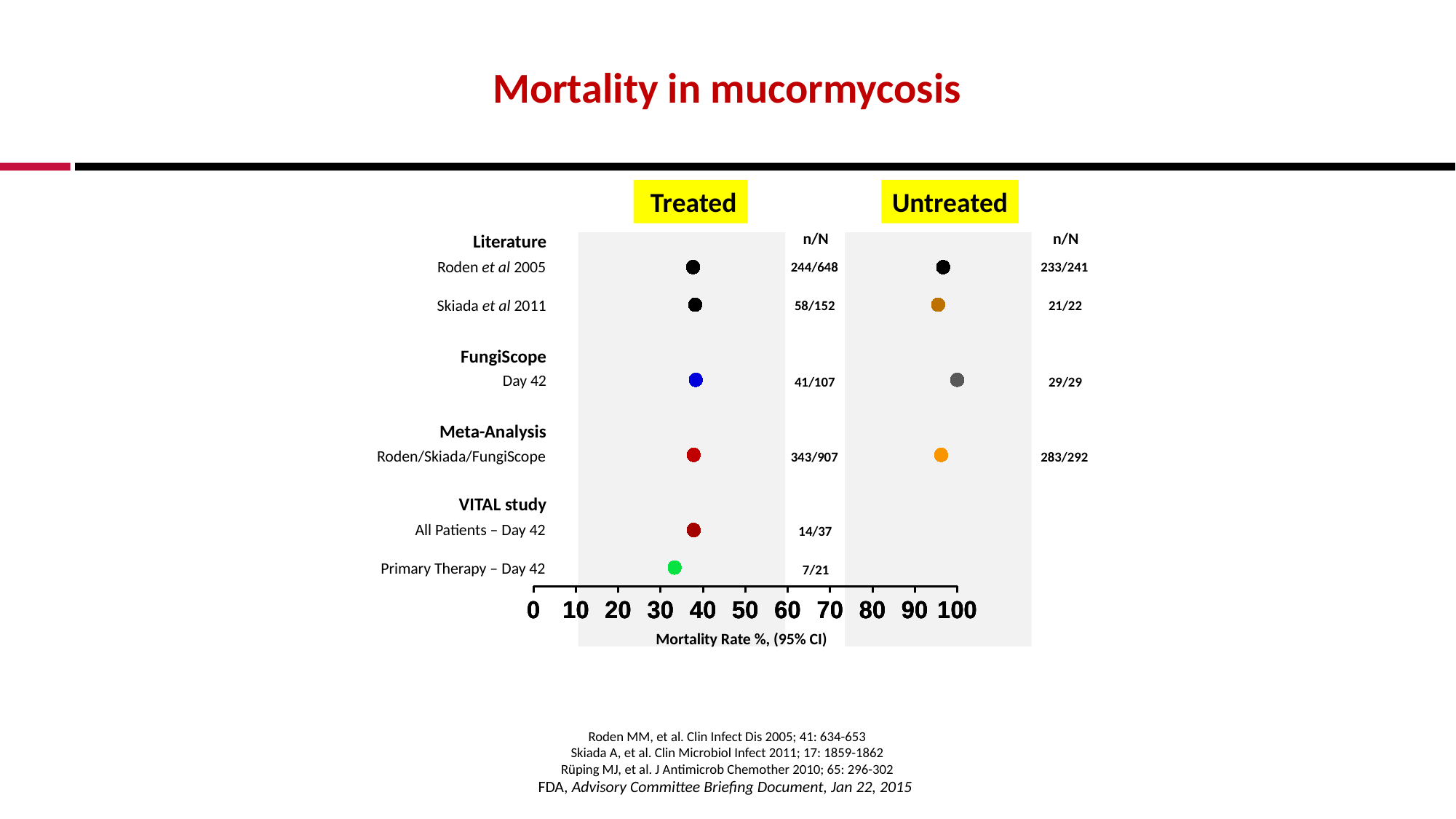
How many data points are plotted in the Untreated column? 4 Is the treated mortality rate for Roden et al 2005 greater or less than 50? less What is the n/N value printed for Roden et al 2005 in the Untreated column? 233/241 What is the n/N value printed for FungiScope Day 42 in the Untreated column? 29/29 Is the mortality rate for Primary Therapy – Day 42 greater or less than 40? less What is the n/N value printed for the Meta-Analysis (Roden/Skiada/FungiScope) in the Treated column? 343/907 What is the n/N value printed for Roden et al 2005 in the Treated column? 244/648 Which has the higher mortality rate for Roden et al 2005: Treated or Untreated? Untreated What is the n/N value printed for Primary Therapy – Day 42 in the VITAL study? 7/21 Which row has the lowest mortality rate in the Treated column? Primary Therapy – Day 42 What is the label of the horizontal axis? Mortality Rate %, (95% CI) Is the untreated mortality rate for Skiada et al 2011 greater or less than 90? greater